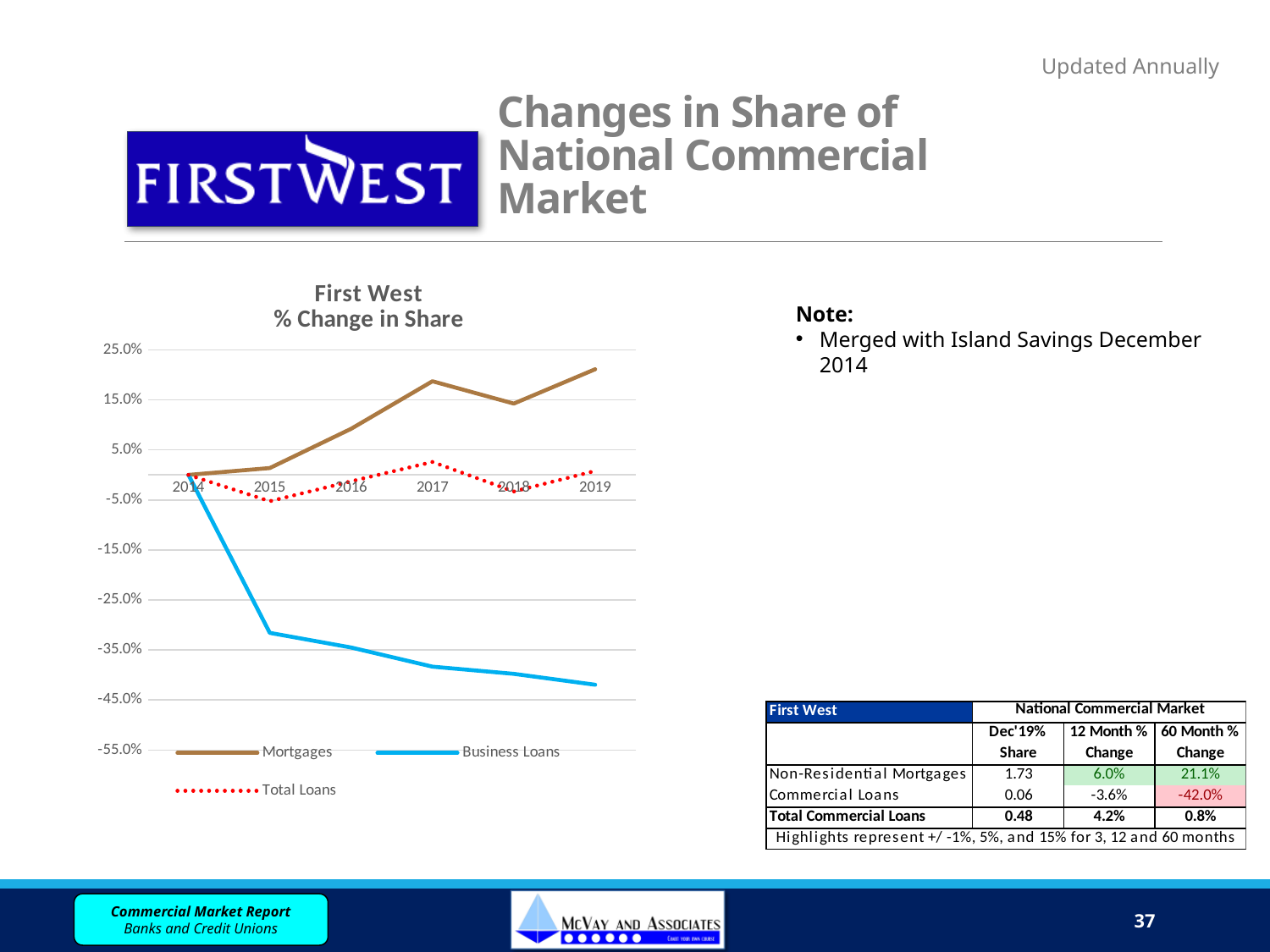
Which is larger for Mortgages: the value in 2017 or the value in 2018? 2017 What kind of chart is shown on the slide? line chart Is the value for Business Loans in 2015 greater or less than -25.0%? less Is the value for Mortgages in 2019 greater or less than 15.0%? greater Is the value for Mortgages in 2016 greater or less than 5.0%? greater What is the title of the chart? First West % Change in Share Do the values for Business Loans rise or fall from 2014 to 2019? fall How many series does the chart legend list? 3 Which series has the highest value in 2019? Mortgages Which series has the lowest value in 2019? Business Loans How many years are plotted along the x axis of the chart? 6